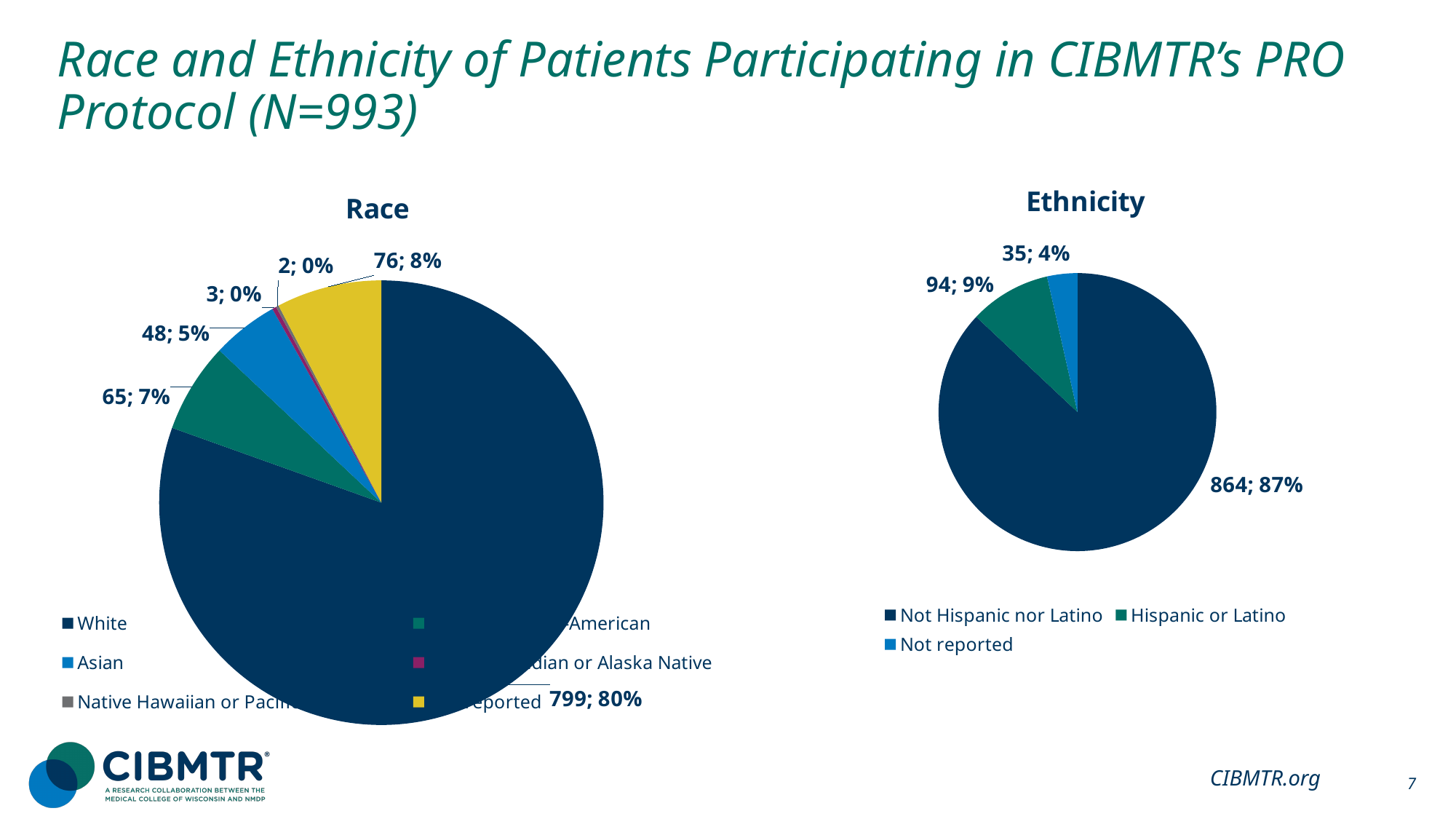
What kind of chart is the Race chart? Pie chart In the Ethnicity pie chart, what is the value shown for Not Hispanic nor Latino? 864; 87% How many slices does the Race pie chart have? 6 How many categories does the legend of the Ethnicity pie chart list? 3 In the Ethnicity pie chart, what is the value shown for Not reported? 35; 4% In the Ethnicity pie chart, which category has the smallest slice? Not reported In the Race pie chart, what is the value shown for Asian? 48; 5% In the Ethnicity pie chart, what is the value shown for Hispanic or Latino? 94; 9% In the Ethnicity pie chart, what is the difference in patient count between Hispanic or Latino and Not reported? 59 In the Ethnicity pie chart, which category has the largest slice? Not Hispanic nor Latino In the Race pie chart, what is the value shown for White? 799; 80% In the Ethnicity pie chart, what share of the pie does Hispanic or Latino represent? 9%